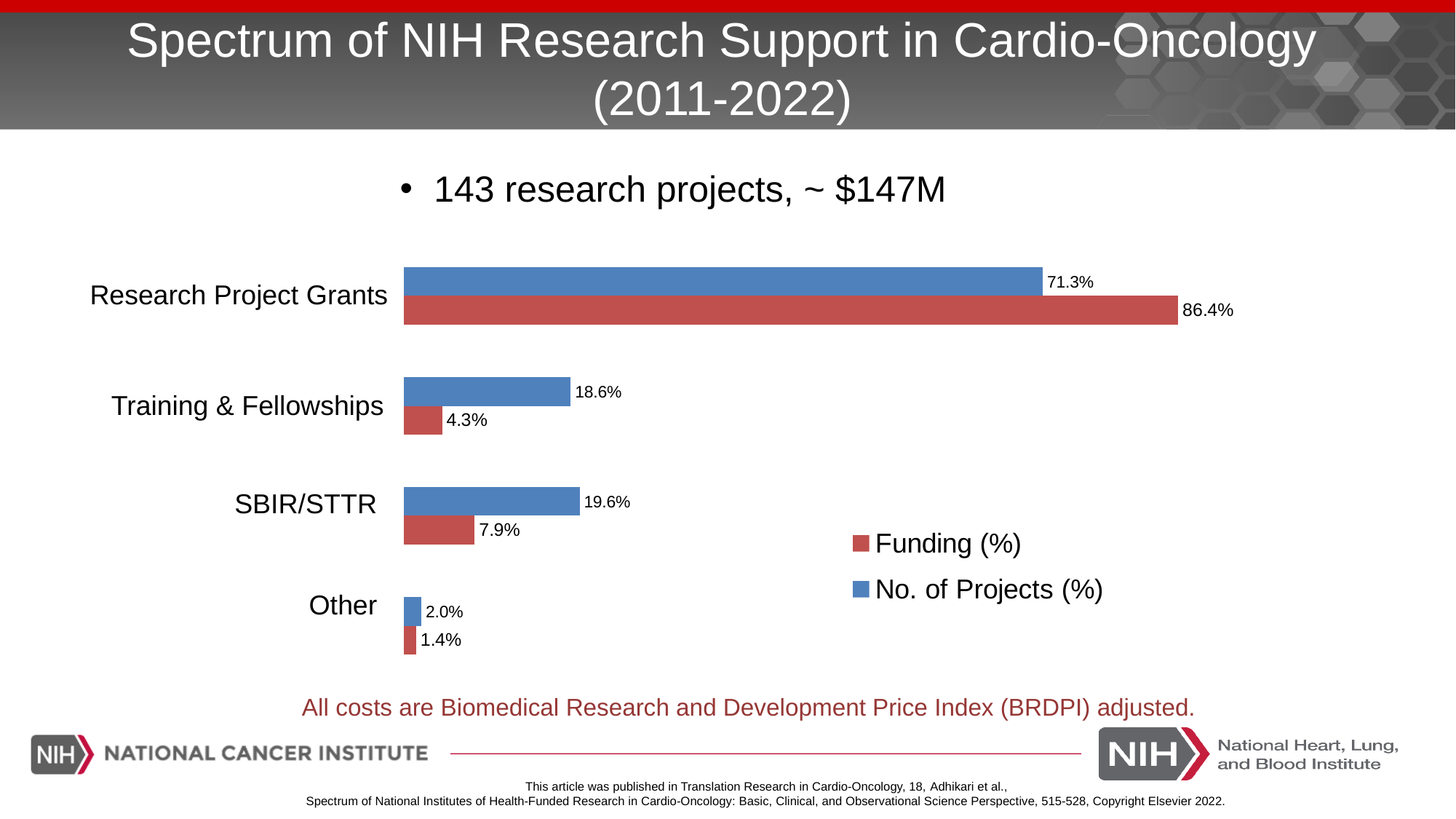
Which category has the lowest No. of Projects (%)? Other Which colour represents the Funding (%) series? Red How many categories are shown on the chart? 4 What kind of chart is shown on the slide? Bar chart What is the difference between the Funding (%) and No. of Projects (%) values for Research Project Grants? 15.1% How many series does the legend list? 2 Which category has the highest Funding (%)? Research Project Grants What is the No. of Projects (%) value for Other? 2.0% What is the Funding (%) value for SBIR/STTR? 7.9% Which is larger for Training & Fellowships: Funding (%) or No. of Projects (%)? No. of Projects (%) What is the Funding (%) value for Research Project Grants? 86.4% What is the No. of Projects (%) value for Training & Fellowships? 18.6%